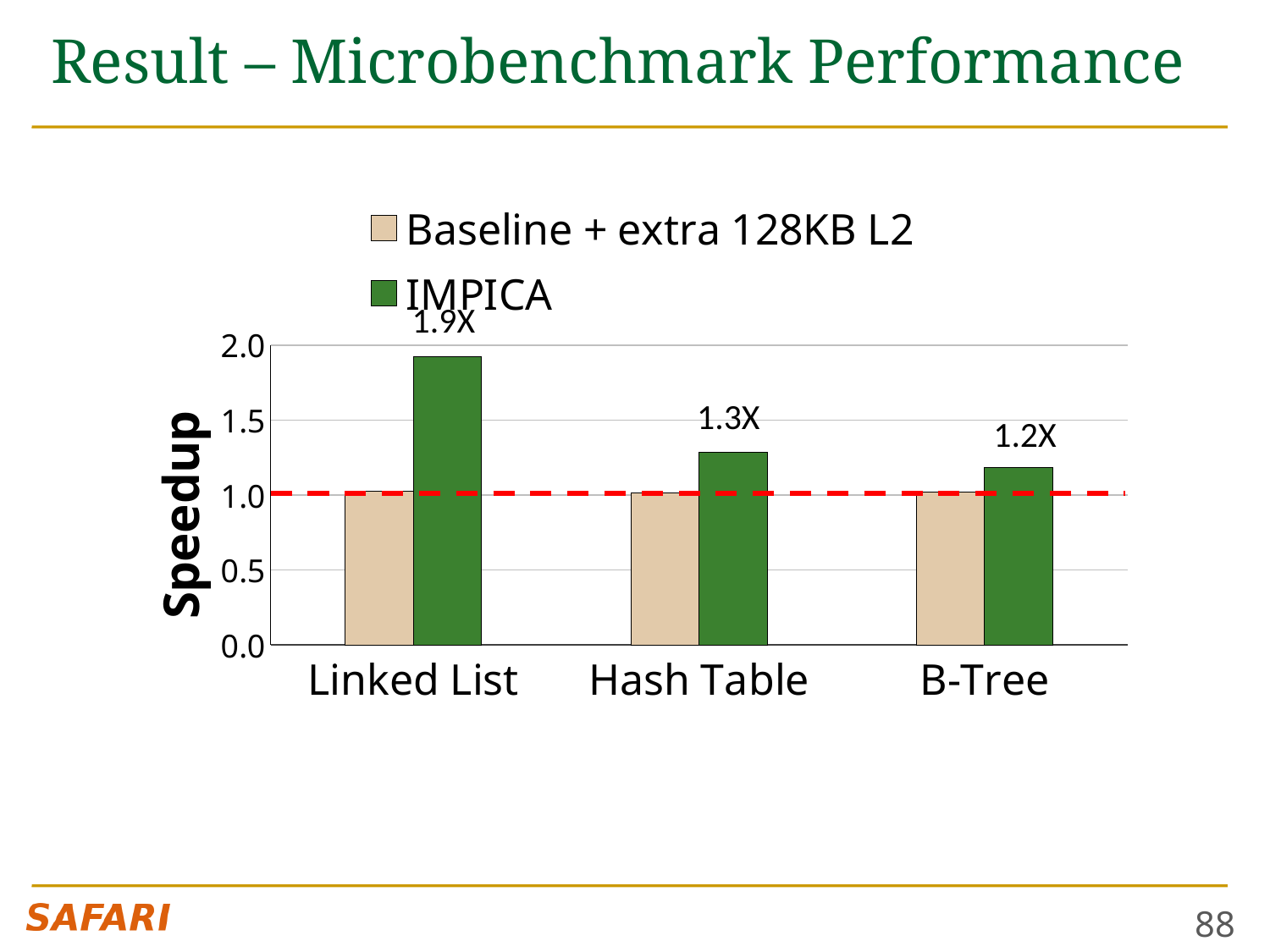
Is the IMPICA speedup for B-Tree greater or less than 1.5? less How many categories are shown on the x axis? 3 Which category has the highest IMPICA speedup? Linked List What is the difference between the IMPICA speedup for Linked List and for Hash Table? 0.6X Which has a larger IMPICA speedup, Hash Table or B-Tree? Hash Table What kind of chart is shown on the slide? bar chart How many series does the legend list? 2 Is the IMPICA speedup for Linked List greater or less than 1.5? greater What is the IMPICA speedup for Hash Table? 1.3X What is the IMPICA speedup for B-Tree? 1.2X What is the IMPICA speedup for Linked List? 1.9X Which category has the lowest IMPICA speedup? B-Tree